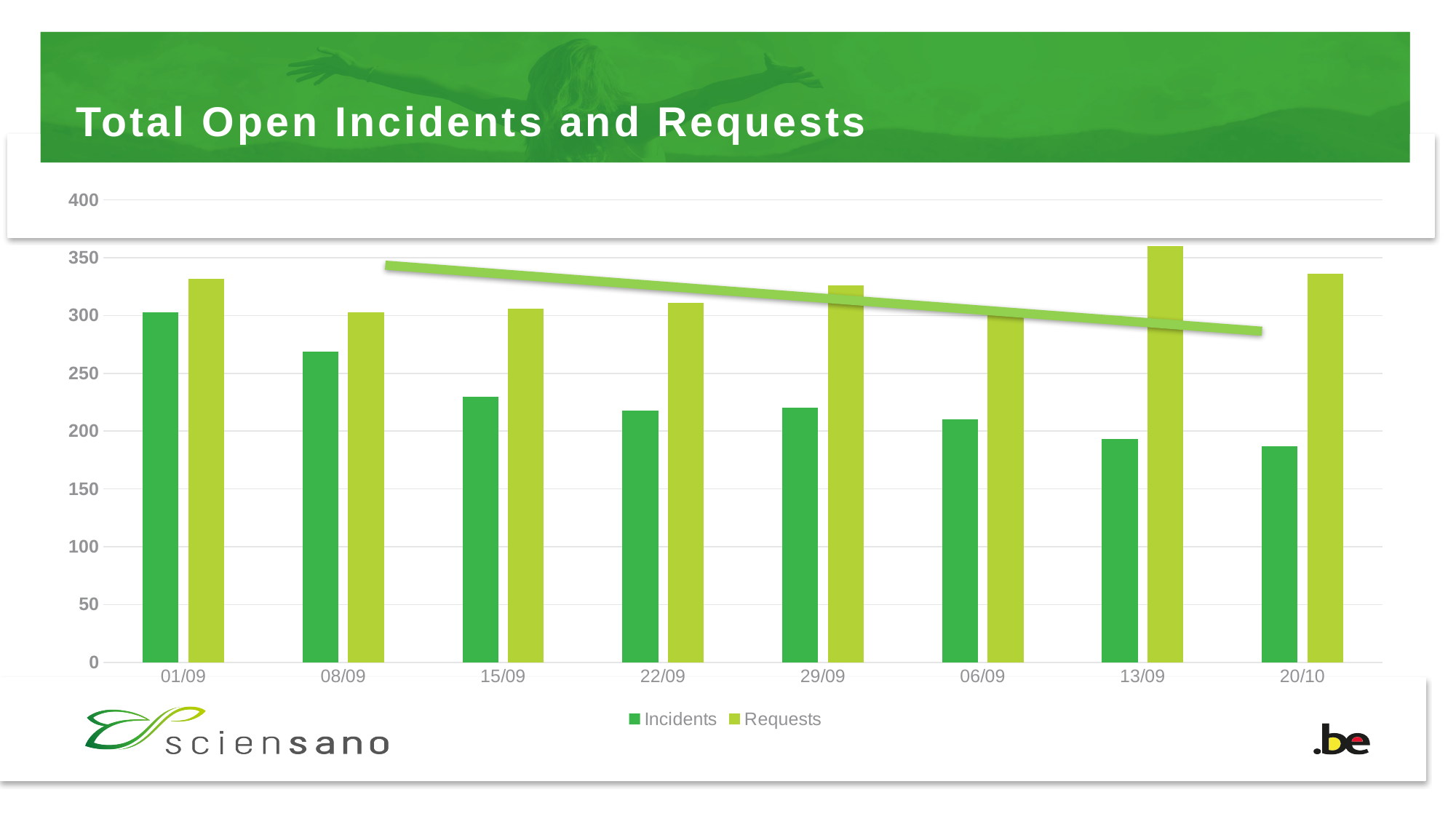
How many series does the legend list? 2 Is the value for Incidents on 20/10 greater or less than 200? less On 13/09, which is larger, Incidents or Requests? Requests Is the value for Requests on 13/09 greater or less than 350? greater What kind of chart is shown on the slide? bar chart Do the Incidents values generally rise or fall from 01/09 to 20/10? fall On which date is the Requests bar highest? 13/09 What is the title of the chart? Total Open Incidents and Requests How many dates are shown on the x axis? 8 On which date is the Incidents bar highest? 01/09 Is the value for Incidents on 15/09 greater or less than 250? less